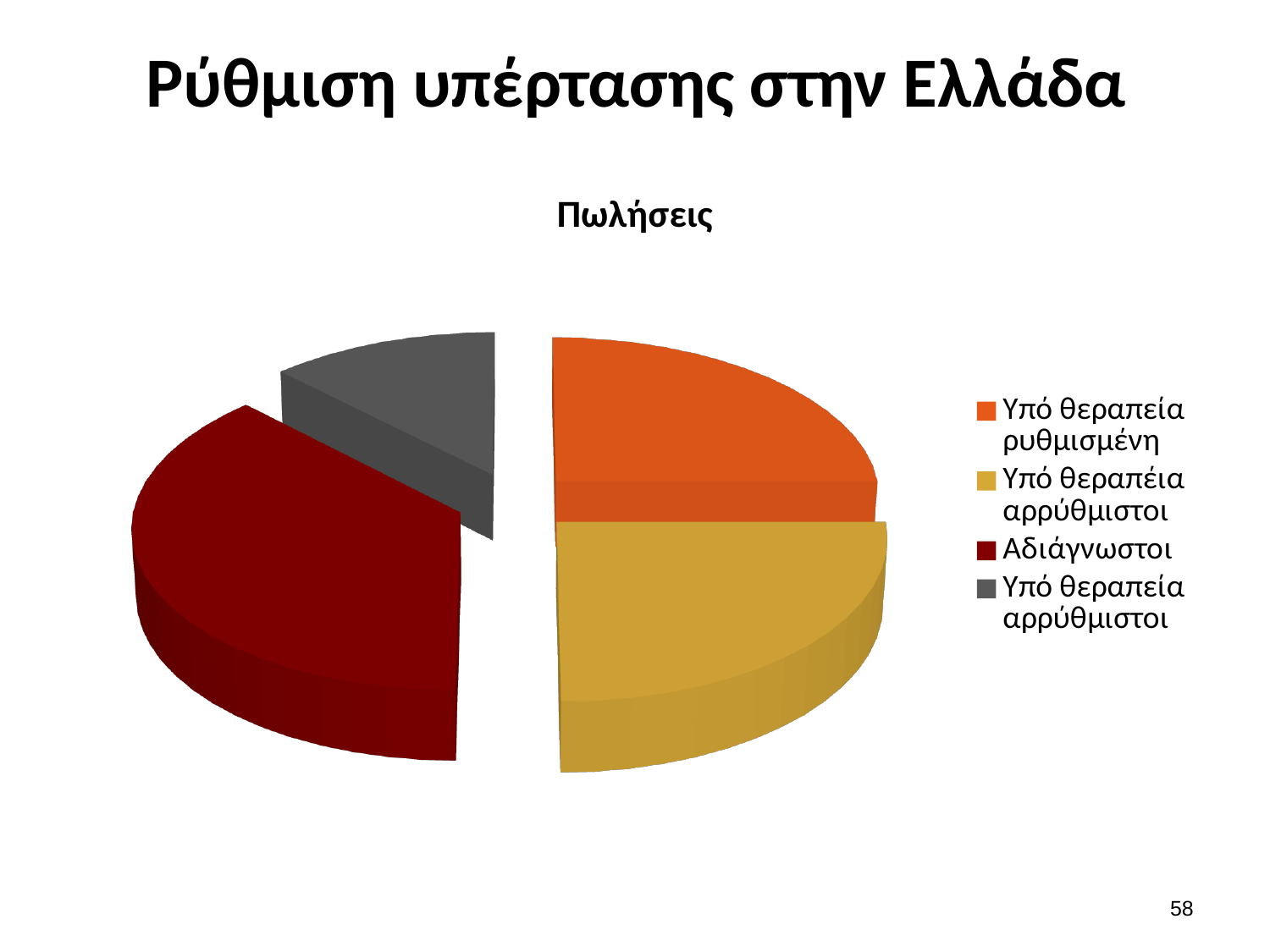
How many entries does the legend of the pie chart list? 4 How many slices does the pie chart have? 4 What is the title of the pie chart? Πωλήσεις Which is larger in the pie chart: the slice for Αδιάγνωστοι or the grey slice? Αδιάγνωστοι What colour is the slice for Αδιάγνωστοι in the pie chart? Dark red Which is larger in the pie chart: the yellow slice or the grey slice? The yellow slice Which colour is the smallest slice of the pie chart? Grey Which is larger in the pie chart: the orange slice (Υπό θεραπεία ρυθμισμένη) or the dark red slice (Αδιάγνωστοι)? Αδιάγνωστοι Which category has the largest slice in the pie chart? Αδιάγνωστοι What kind of chart is shown on the slide? Pie chart